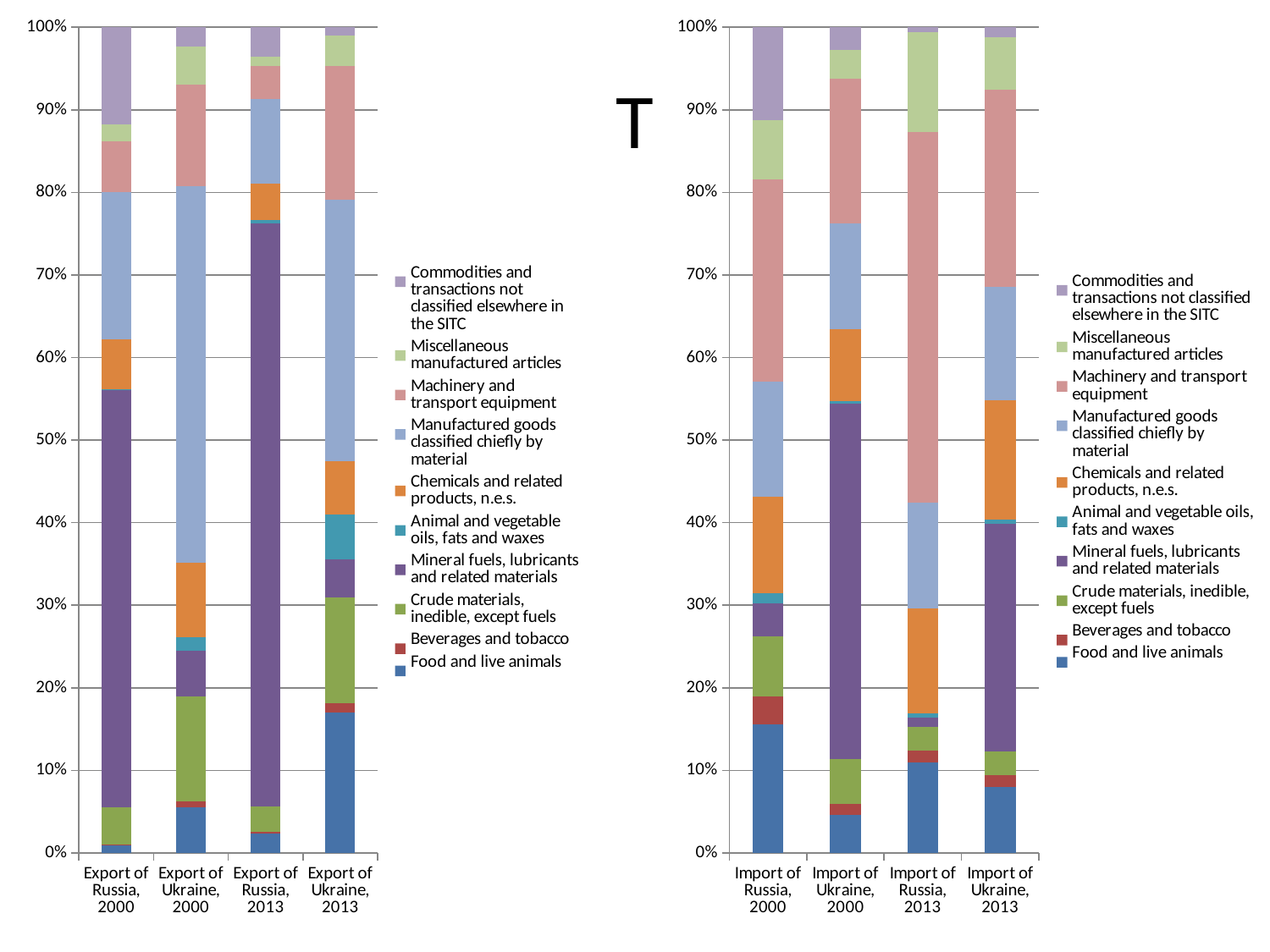
In the right chart (imports), is the Machinery and transport equipment share for Import of Russia, 2013 greater or less than 40%? greater In the right chart (imports), is the Food and live animals share for Import of Ukraine, 2000 greater or less than 10%? less How many series does the legend of the right chart, showing imports, list? 10 What is the total height of each stacked bar in the left chart (exports)? 100% How many bars (categories) does the left chart, showing exports, have? 4 In the right chart (imports), which bar has the larger Food and live animals share: Import of Russia, 2000 or Import of Ukraine, 2000? Import of Russia, 2000 In the right chart (imports), what colour represents Mineral fuels, lubricants and related materials in the legend? Purple In the left chart (exports), which bar has the larger Mineral fuels, lubricants and related materials share: Export of Russia, 2013 or Export of Ukraine, 2013? Export of Russia, 2013 What kind of chart is the left chart on the slide? Stacked bar chart In the left chart (exports), is the Food and live animals share for Export of Ukraine, 2013 greater or less than 10%? greater